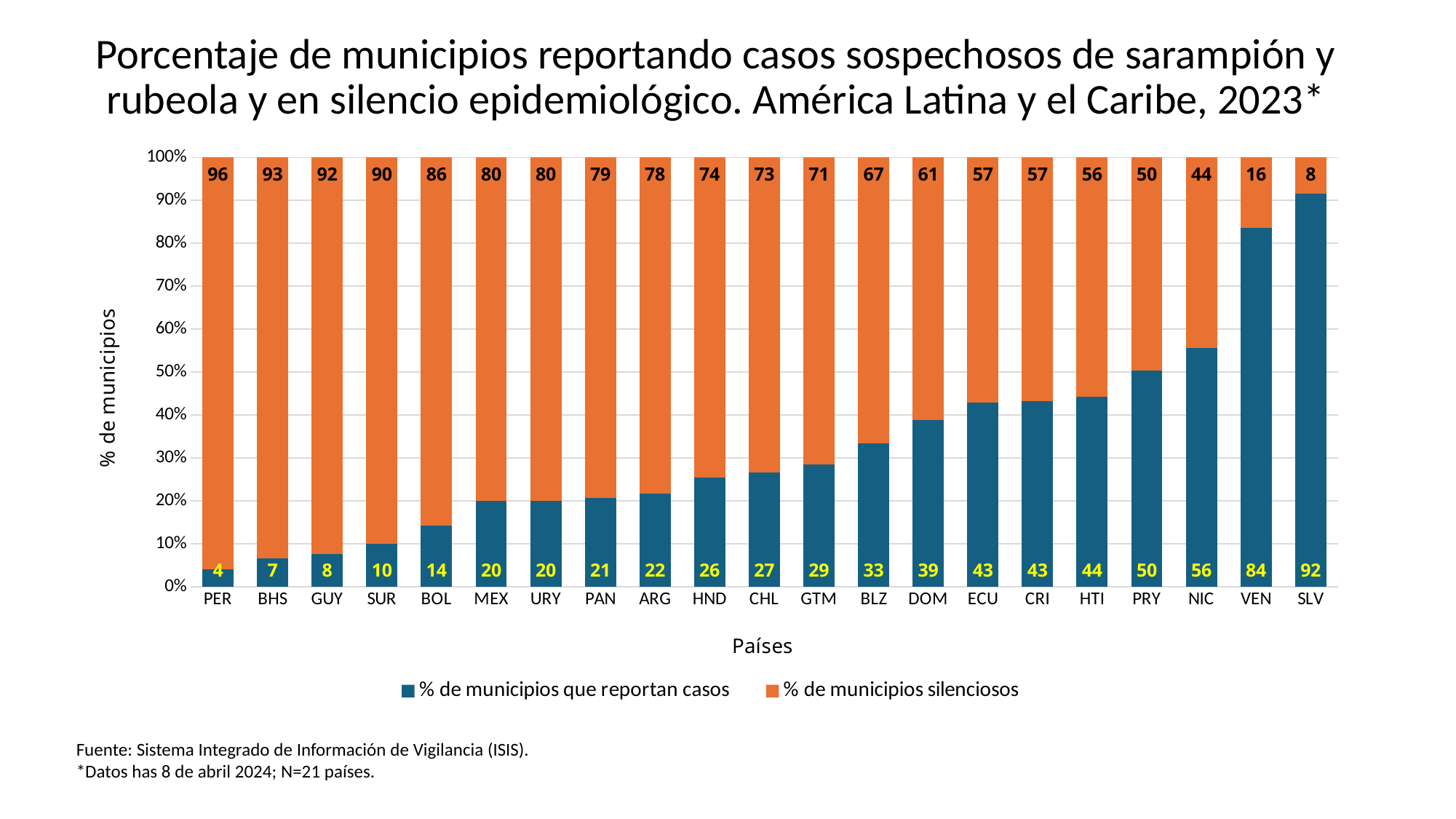
What is the value for % de municipios que reportan casos for MEX? 20 Is the value for % de municipios que reportan casos for PRY greater or less than 40%? greater What kind of chart is shown on the slide? Stacked bar chart Do the values for % de municipios que reportan casos rise or fall from left to right along the x axis? Rise What is the difference between the % de municipios que reportan casos for VEN and for NIC? 28 What is the value for % de municipios que reportan casos for SLV? 92 How many series does the legend list? 2 Which has a larger % de municipios que reportan casos, DOM or BLZ? DOM Which country has the highest % de municipios que reportan casos? SLV Which country has the lowest % de municipios que reportan casos? PER How many countries are shown on the x axis? 21 What is the value for % de municipios silenciosos for PER? 96